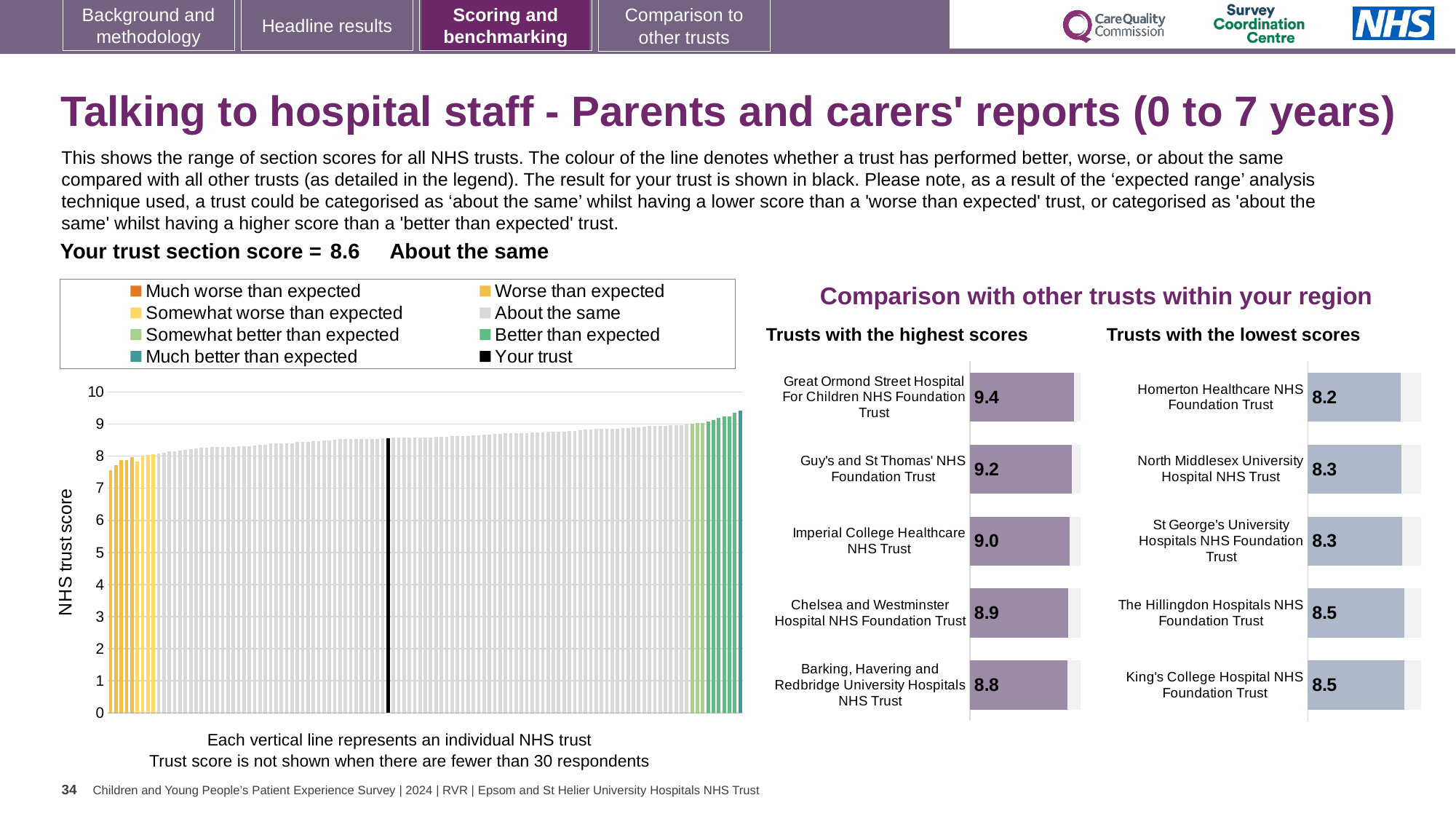
In the 'Trusts with the lowest scores' chart, what is the score for Homerton Healthcare NHS Foundation Trust? 8.2 How many trusts are shown in the 'Trusts with the lowest scores' chart? 5 How many entries does the legend of the large chart on the left list? 8 In the 'Trusts with the lowest scores' chart, which trust has the lowest score? Homerton Healthcare NHS Foundation Trust In the large chart on the left, do the trust scores rise or fall from left to right? rise In the 'Trusts with the highest scores' chart, which trust has the highest score? Great Ormond Street Hospital For Children NHS Foundation Trust In the 'Trusts with the highest scores' chart, what is the difference between the scores of Great Ormond Street Hospital For Children NHS Foundation Trust and Barking, Havering and Redbridge University Hospitals NHS Trust? 0.6 In the large chart on the left, is the value for 'Your trust' (the black line) greater or less than 8? greater In the 'Trusts with the highest scores' chart, what is the score for Great Ormond Street Hospital For Children NHS Foundation Trust? 9.4 In the 'Trusts with the lowest scores' chart, what is the score for The Hillingdon Hospitals NHS Foundation Trust? 8.5 In the 'Trusts with the highest scores' chart, which has the higher score: Guy's and St Thomas' NHS Foundation Trust or Chelsea and Westminster Hospital NHS Foundation Trust? Guy's and St Thomas' NHS Foundation Trust In the 'Trusts with the highest scores' chart, what is the score for Imperial College Healthcare NHS Trust? 9.0